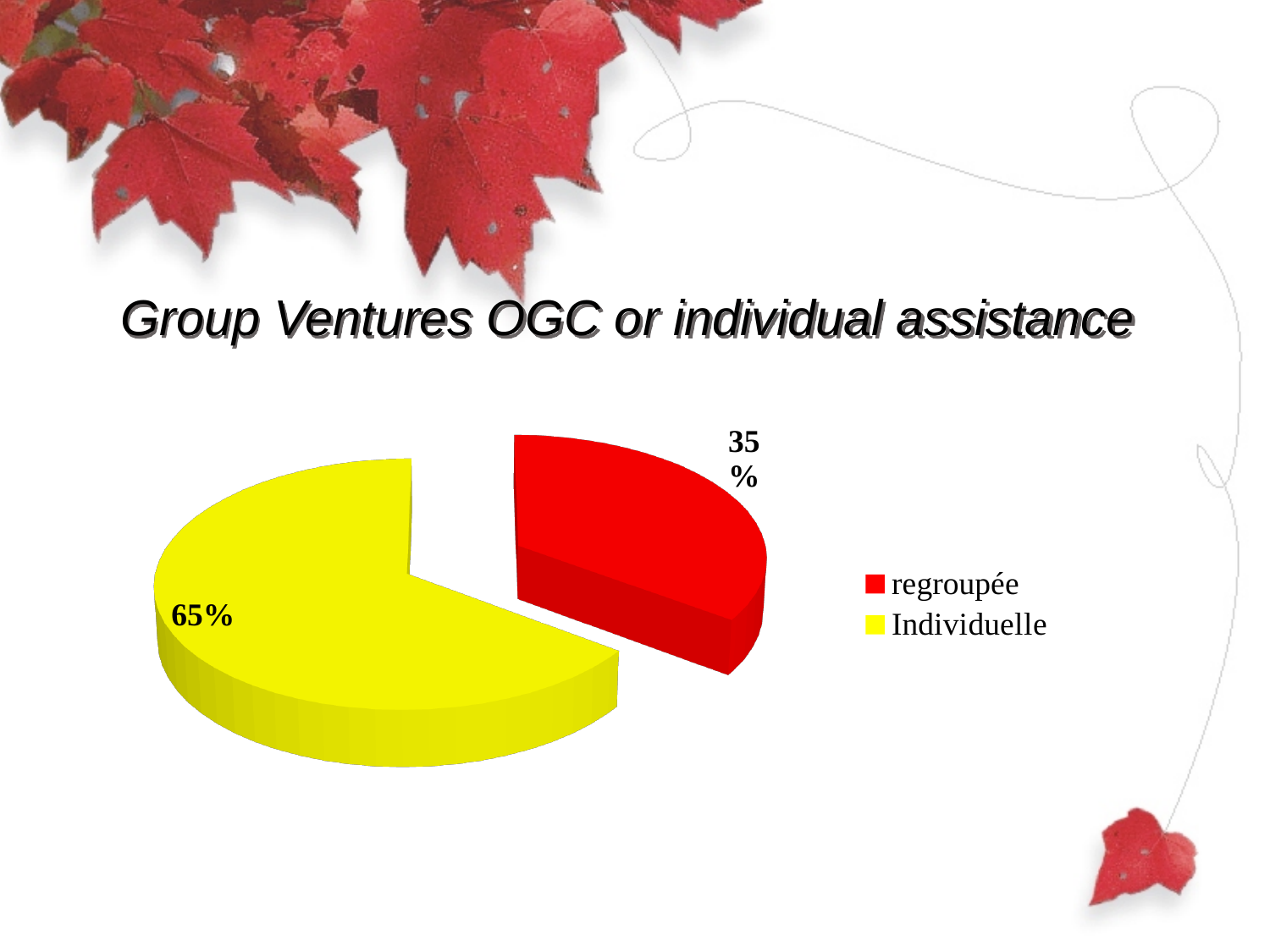
What is the difference in percentage points between the 'Individuelle' and 'regroupée' slices? 30 What colour is the 'regroupée' slice? red Which category has the largest share of the pie? Individuelle Which category has the smallest share of the pie? regroupée What colour is the 'Individuelle' slice? yellow What kind of chart is shown on the slide? pie chart Which is larger, the share for 'regroupée' or the share for 'Individuelle'? Individuelle How many slices does the pie chart have? 2 What percentage does the 'Individuelle' slice represent? 65% How many entries does the legend list? 2 What percentage does the 'regroupée' slice represent? 35%